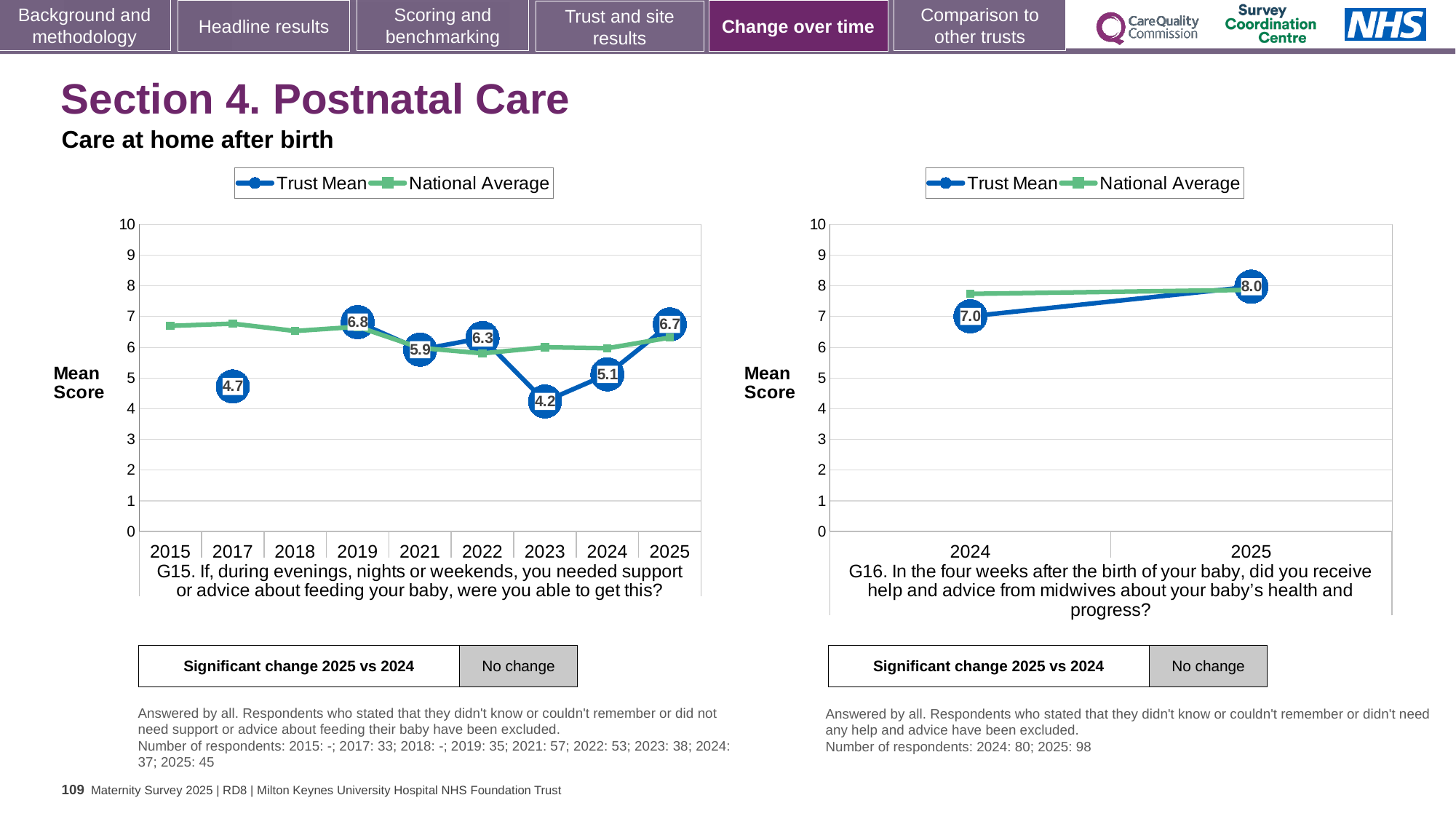
How many series does the legend of the G15 chart on the left list? 2 In the G15 chart on the left, is the National Average for 2015 greater or less than 6? greater In the G16 chart on the right, what is the difference between the Trust Mean for 2025 and 2024? 1.0 In the G15 chart on the left, what is the Trust Mean for 2019? 6.8 What kind of chart is the G16 chart on the right? Line chart In the G15 chart on the left, which year has the lowest labelled Trust Mean? 2023 In the G15 chart on the left, what is the Trust Mean for 2023? 4.2 In the G16 chart on the right, what is the Trust Mean for 2025? 8.0 In the G15 chart on the left, which year has the highest labelled Trust Mean? 2019 In the G15 chart on the left, what is the difference between the Trust Mean for 2025 and 2024? 1.6 How many years are shown on the x axis of the G16 chart on the right? 2 In the G15 chart on the left, which is larger, the Trust Mean for 2022 or for 2024? 2022